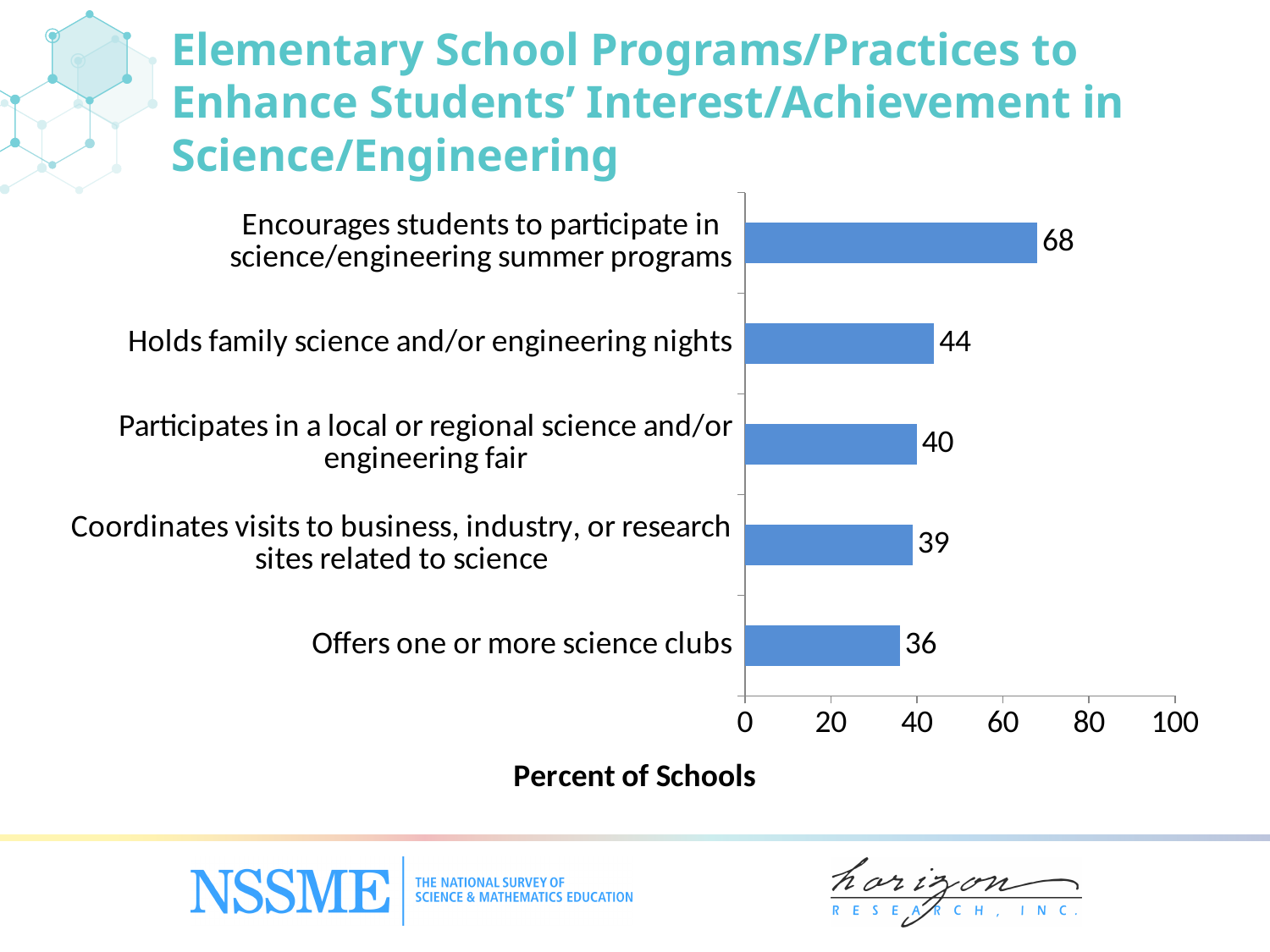
Which program/practice has the lowest percent of schools? Offers one or more science clubs What percent of schools offer one or more science clubs? 36 What is the difference between the value for summer programs (68) and the value for family science and/or engineering nights (44)? 24 What kind of chart is shown on the slide? Bar chart What percent of schools encourage students to participate in science/engineering summer programs? 68 Which is larger: the value for 'Participates in a local or regional science and/or engineering fair' or the value for 'Offers one or more science clubs'? Participates in a local or regional science and/or engineering fair What is the value for 'Holds family science and/or engineering nights'? 44 What is the label of the horizontal axis? Percent of Schools Is the value for 'Holds family science and/or engineering nights' greater or less than 40? greater What is the value for 'Coordinates visits to business, industry, or research sites related to science'? 39 Which program/practice has the highest percent of schools? Encourages students to participate in science/engineering summer programs How many programs/practices are shown in the chart? 5